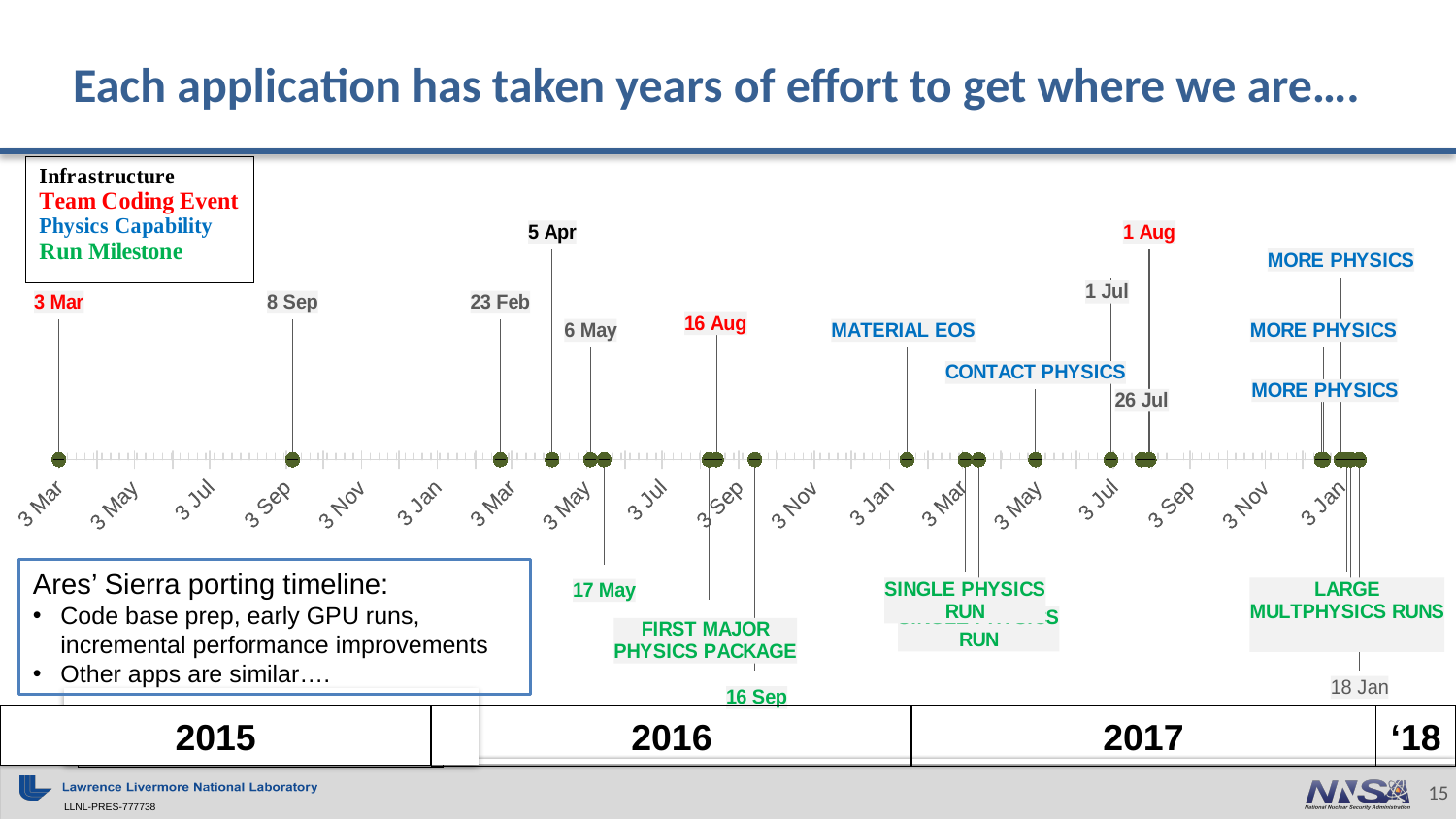
What kind of chart is shown on the slide? Timeline Which years are labelled along the bottom of the timeline? 2015, 2016, 2017, '18 How many Team Coding Event (red) dates are marked on the timeline? 3 Which legend category is shown in red? Team Coding Event What date is labelled below the 'FIRST MAJOR PHYSICS PACKAGE' milestone? 16 Sep What is the red-labelled Team Coding Event date in 2016? 16 Aug How many event categories does the legend list? 4 How many 'MORE PHYSICS' labels appear on the timeline? 3 Which legend category is shown in green? Run Milestone What date is labelled below the 'LARGE MULTPHYSICS RUNS' milestone? 18 Jan What is the first dated event on the timeline, in 2015? 3 Mar What is the red-labelled Team Coding Event date in 2017? 1 Aug